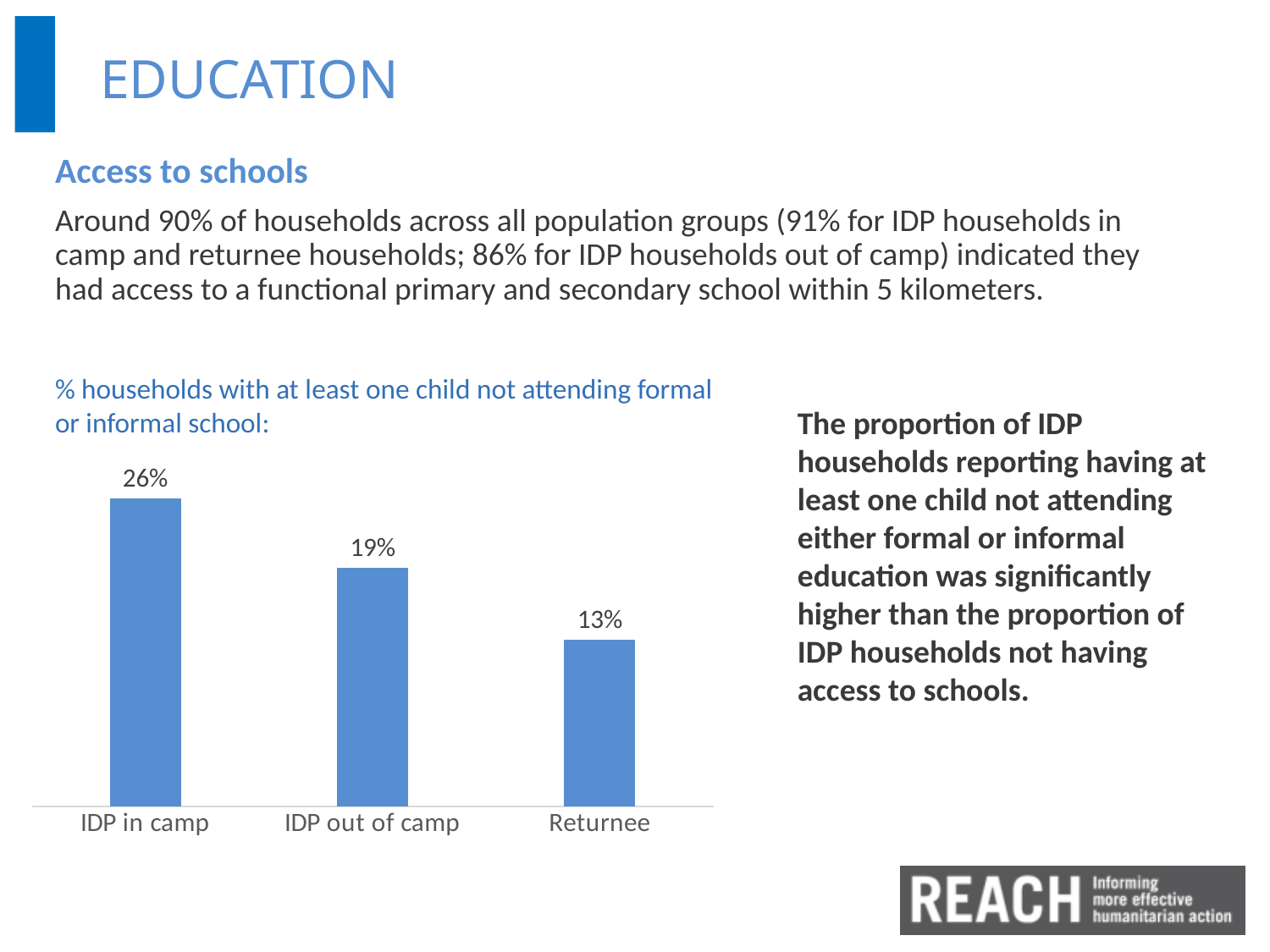
What type of chart is used on the slide? Bar chart What is the difference in percentage points between IDP in camp and Returnee households? 13 percentage points Which population group has the lowest percentage of households with at least one child not attending school? Returnee Which is larger, the value for IDP out of camp or the value for Returnee? IDP out of camp What is the value shown for IDP out of camp? 19% How many population groups are shown in the chart? 3 What percentage of IDP in camp households have at least one child not attending formal or informal school? 26% What is the difference in percentage points between IDP in camp and IDP out of camp? 7 percentage points Which population group has the highest percentage of households with at least one child not attending school? IDP in camp What is the value shown for Returnee households? 13% What does the chart measure, according to its title? % households with at least one child not attending formal or informal school Do the values rise or fall moving from left to right across the categories? Fall